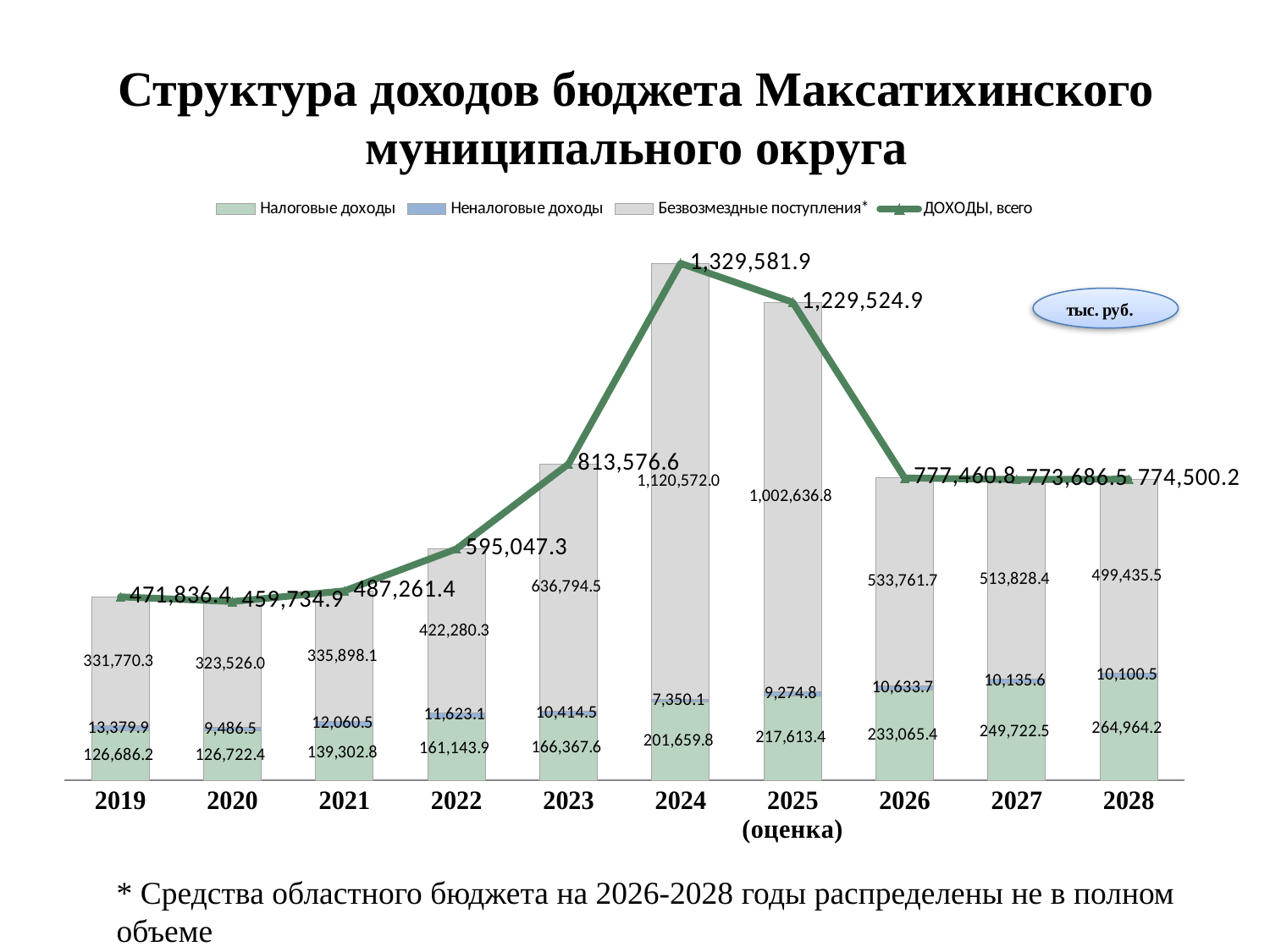
Which year has the larger value of Безвозмездные поступления, 2026 or 2027? 2026 How many series does the legend list? 4 What is the difference between ДОХОДЫ, всего in 2024 and in 2025? 100,057.0 What is the value of Налоговые доходы for 2028? 264,964.2 In which year is ДОХОДЫ, всего the highest? 2024 What is the value of Безвозмездные поступления for 2023? 636,794.5 How many years are shown on the x axis? 10 What kind of chart is shown on the slide? Stacked bar chart with a line Do the values of Налоговые доходы rise or fall from 2019 to 2028? Rise What is the value of Неналоговые доходы for 2021? 12,060.5 In which year is ДОХОДЫ, всего the lowest? 2020 What is the value of ДОХОДЫ, всего for 2024? 1,329,581.9